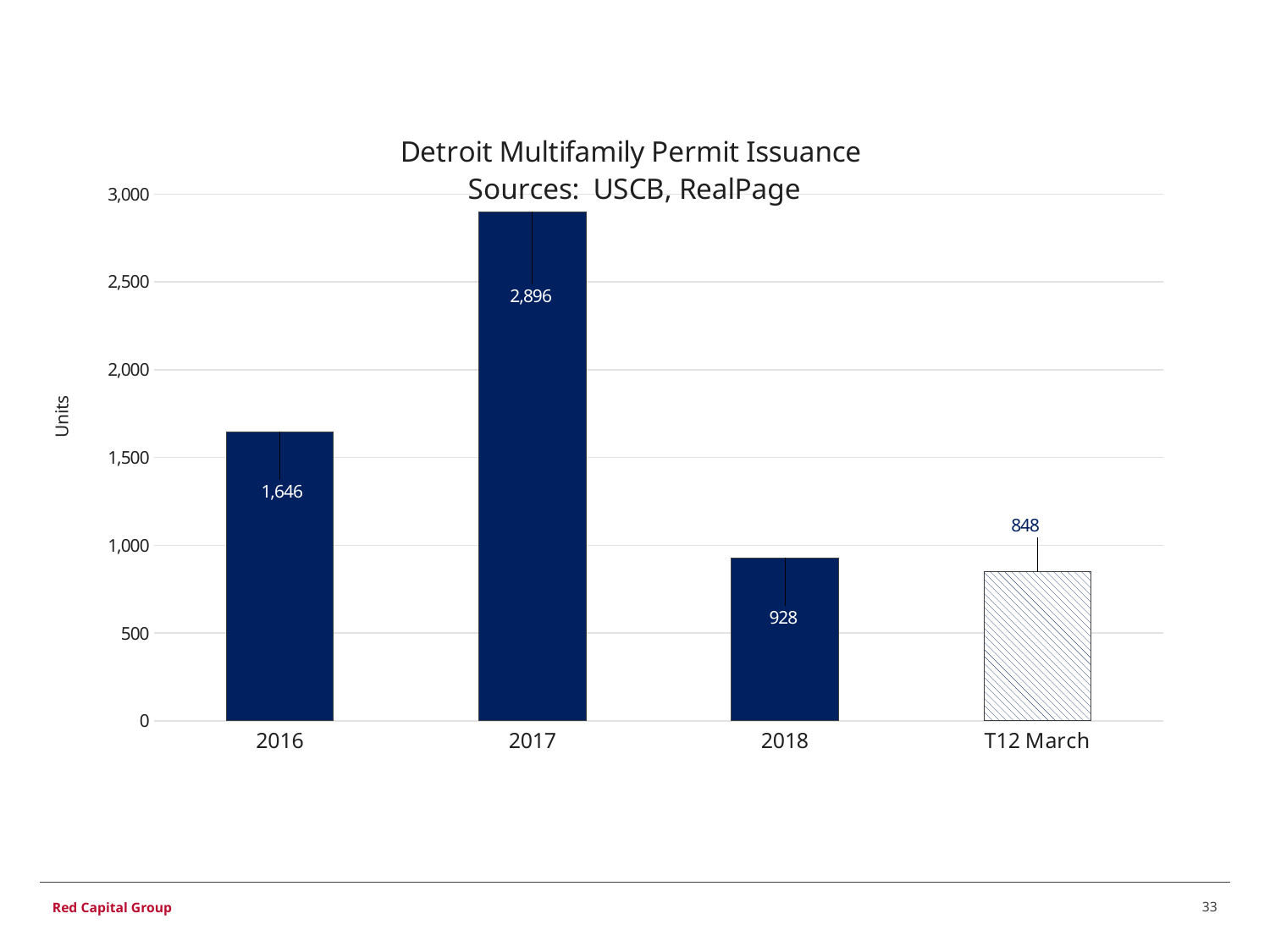
How many categories are shown on the x axis? 4 What is the value for T12 March? 848 What is the difference between the values for 2017 and 2016? 1,250 What is the label on the y axis? Units What is the value for 2016? 1,646 Which category has the lowest value? T12 March Which is larger, the value for 2016 or the value for 2018? 2016 What is the value for 2017? 2,896 What is the value for 2018? 928 What kind of chart is this? Bar chart What is the difference between the values for 2018 and T12 March? 80 Which category has the highest value? 2017